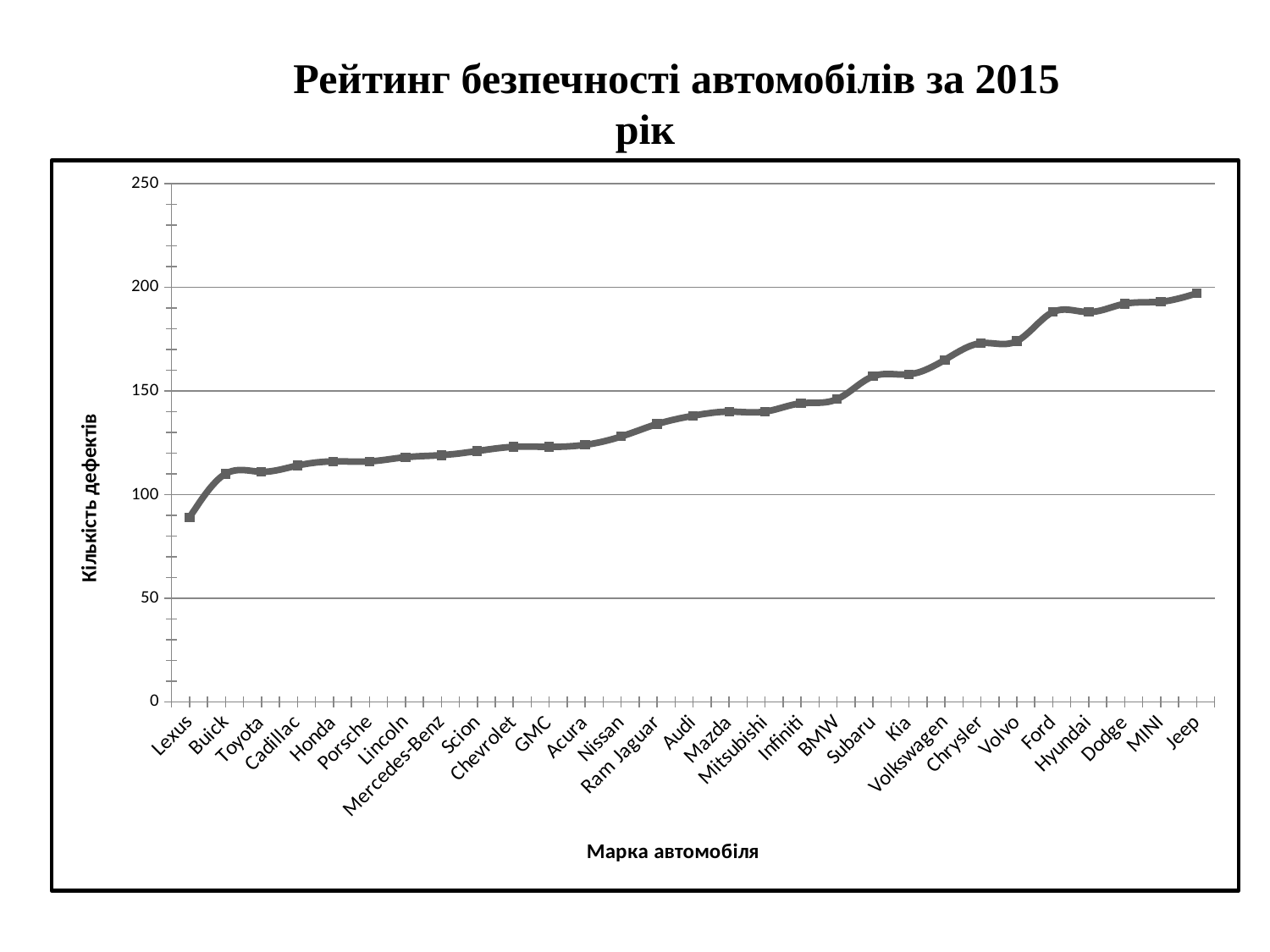
What is the label of the vertical axis? Кількість дефектів Is the value for Subaru greater or less than 150? greater Which car brand has the lowest number of defects? Lexus Do the values rise or fall moving from Lexus to Jeep along the x axis? rise Which has fewer defects, Toyota or Subaru? Toyota Is the value for Lexus greater or less than 100? less What kind of chart is shown on the slide? line chart What is the title of the chart? Рейтинг безпечності автомобілів за 2015 рік Which has more defects, Ford or Honda? Ford Which car brand has the highest number of defects? Jeep Is the value for Honda greater or less than 100? greater